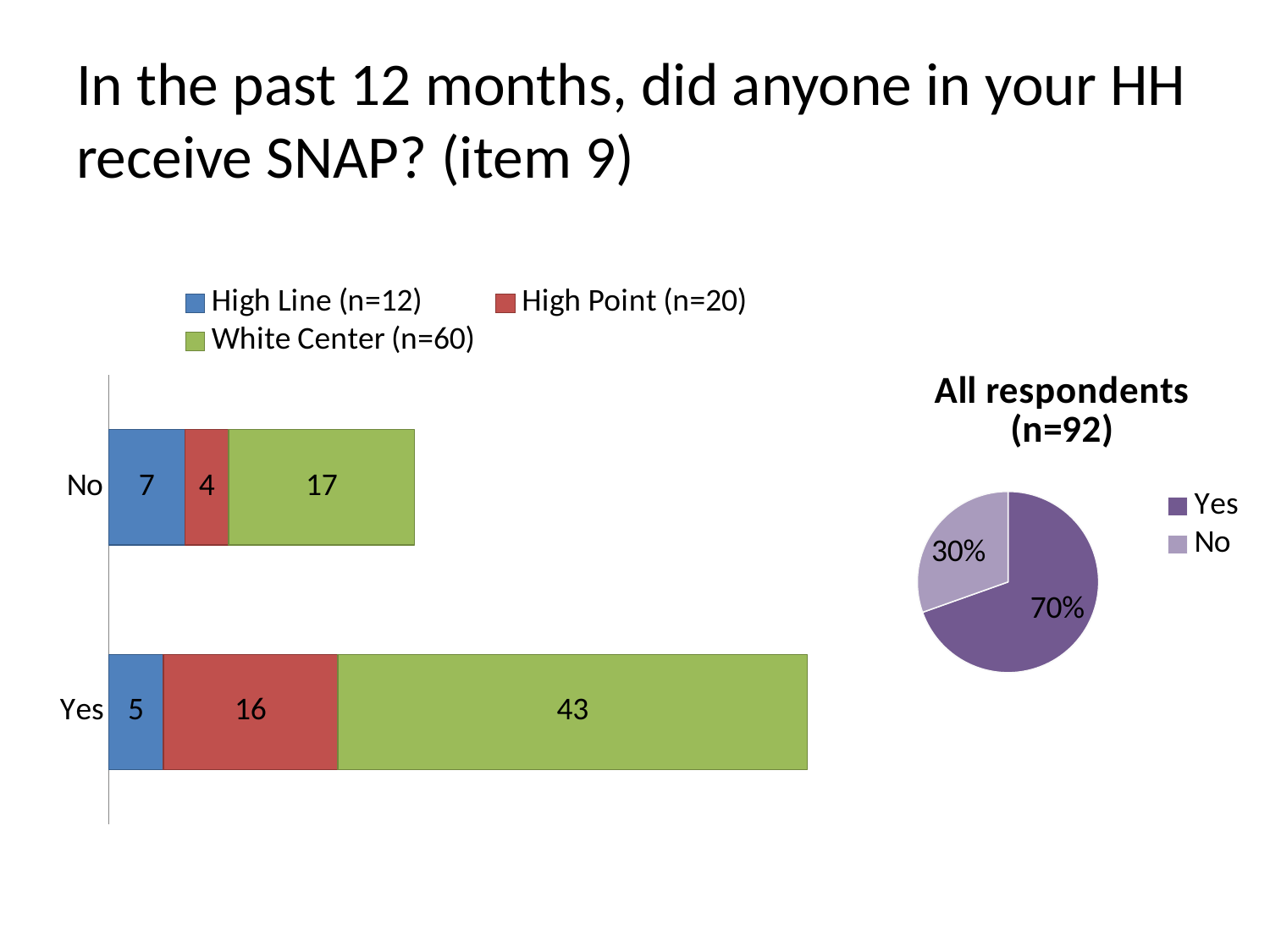
In the stacked bar chart on the left, what is the value for High Point (n=20) in the No category? 4 In the stacked bar chart on the left, what is the value for White Center (n=60) in the Yes category? 43 In the stacked bar chart on the left, what is the total of the No bar across all three series? 28 In the stacked bar chart on the left, which is larger for High Line (n=12): the Yes value or the No value? No What kind of chart is the chart on the left of the slide? Stacked bar chart In the stacked bar chart on the left, what is the total of the Yes bar across all three series? 64 In the pie chart titled 'All respondents (n=92)', which slice is the smallest? No In the pie chart titled 'All respondents (n=92)', what share of respondents answered Yes? 70% In the stacked bar chart on the left, how many categories are shown on the vertical axis? 2 In the stacked bar chart on the left, what is the value for High Line (n=12) in the Yes category? 5 In the stacked bar chart on the left, what is the difference between the White Center (n=60) values for Yes and No? 26 In the stacked bar chart on the left, how many series does the legend list? 3